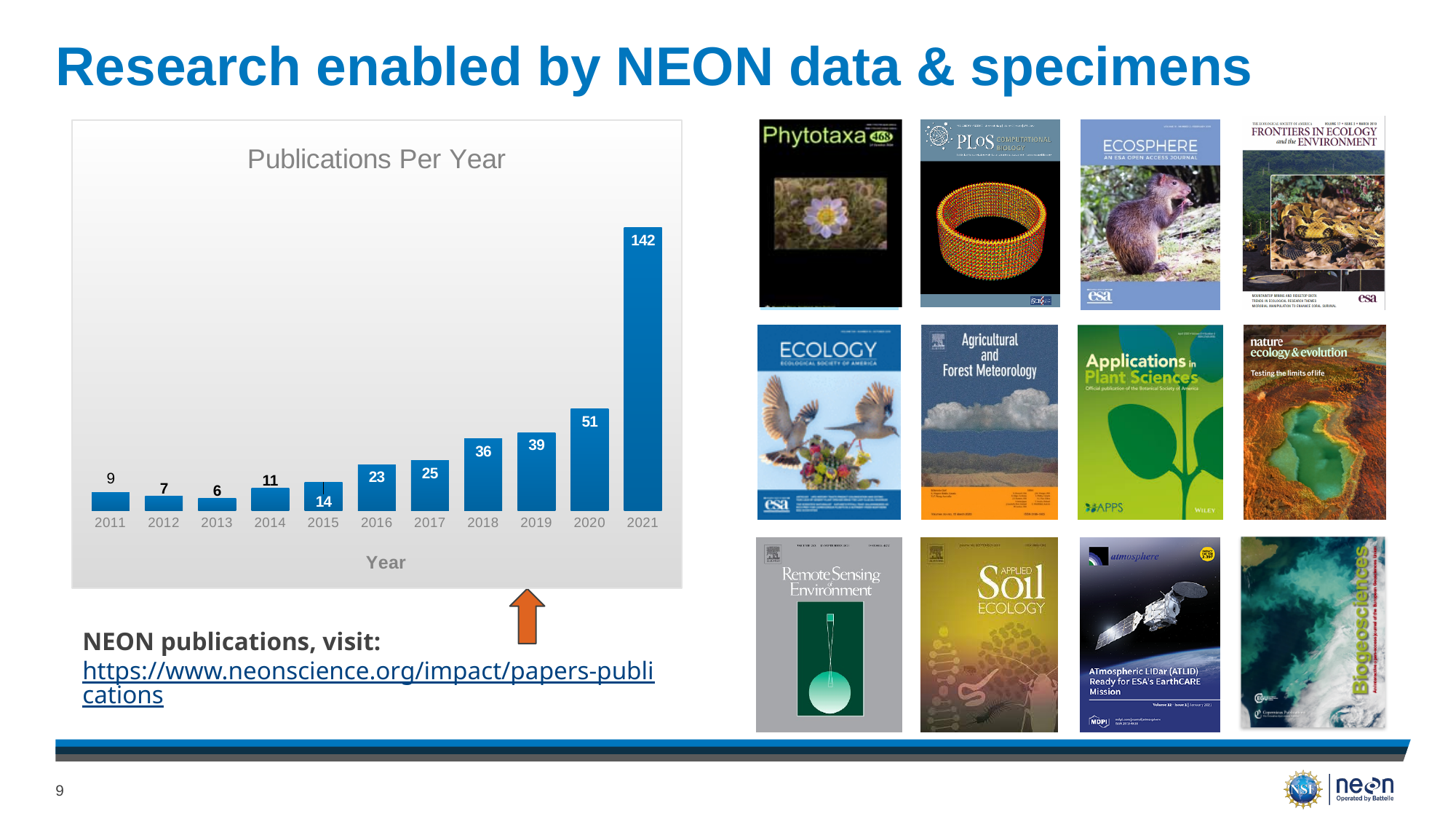
Do the publication counts generally rise or fall from 2013 to 2021? rise How many publications are shown for 2021? 142 Which year has the highest number of publications? 2021 How many publications are shown for 2018? 36 What is the difference in publications between 2021 and 2020? 91 How many publications are shown for 2015? 14 How many years are shown on the x axis? 11 Which year had more publications, 2016 or 2017? 2017 What is the title of the chart? Publications Per Year Which year has the lowest number of publications? 2013 What is the label of the x axis? Year What type of chart is shown on the slide? bar chart